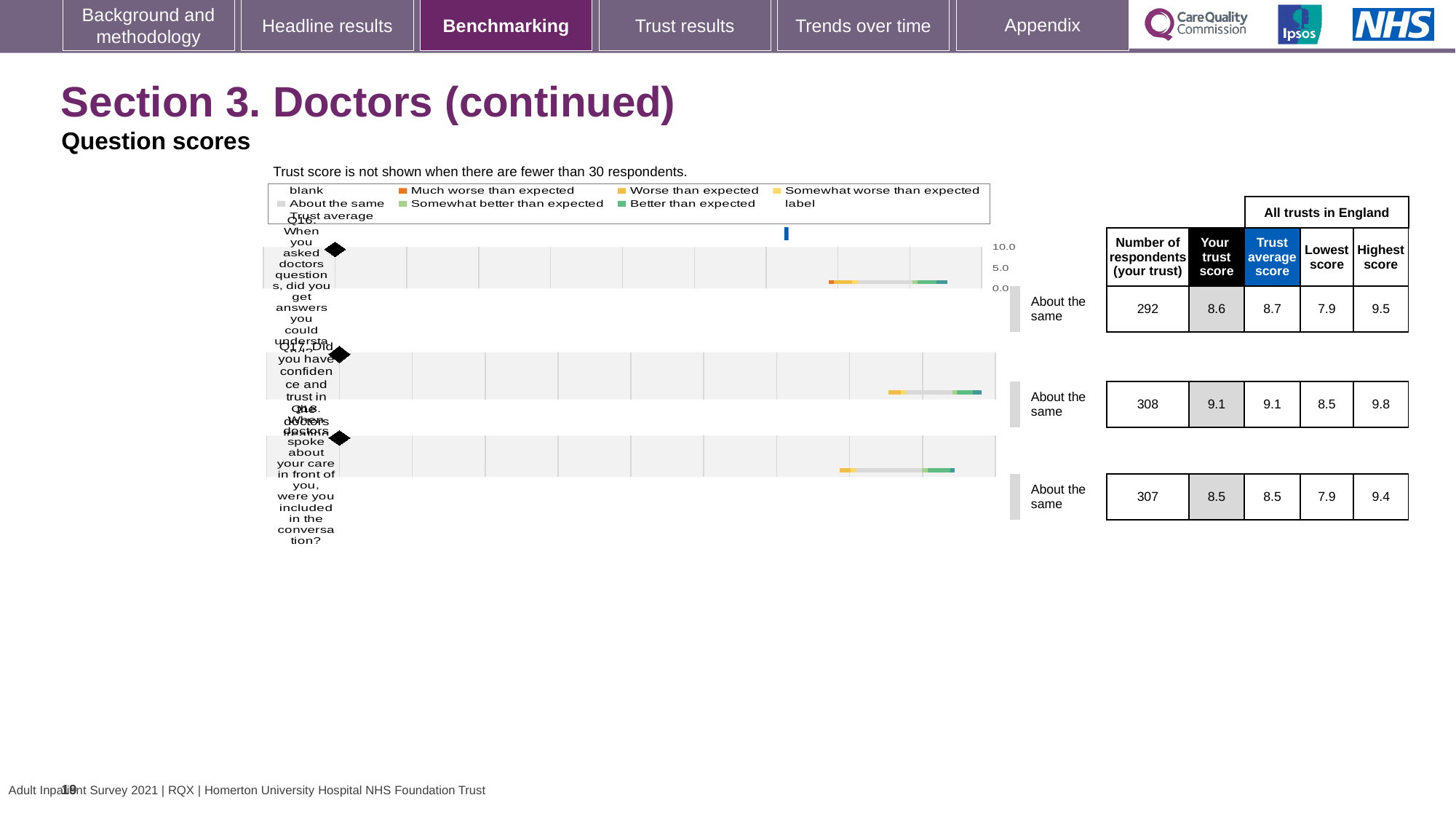
What benchmark category is shown for Q16? About the same How many respondents from your trust answered Q16? 292 What is the maximum value shown on the chart's score axis? 10.0 What is the highest score across all trusts in England for Q18? 9.4 For Q16, which is larger: your trust score or the trust average score? Trust average score How many questions (categories) are plotted in the chart? 3 Which question has the lowest 'Your trust score'? Q18 For Q17, what is the difference between the highest score and the lowest score across all trusts in England? 1.3 Which question has the highest 'Your trust score'? Q17 What is the 'Your trust score' for Q17 (Did you have confidence and trust in the doctors treating you)? 9.1 What kind of chart is used to show the question scores on this slide? bar chart What is the lowest score across all trusts in England for Q17? 8.5